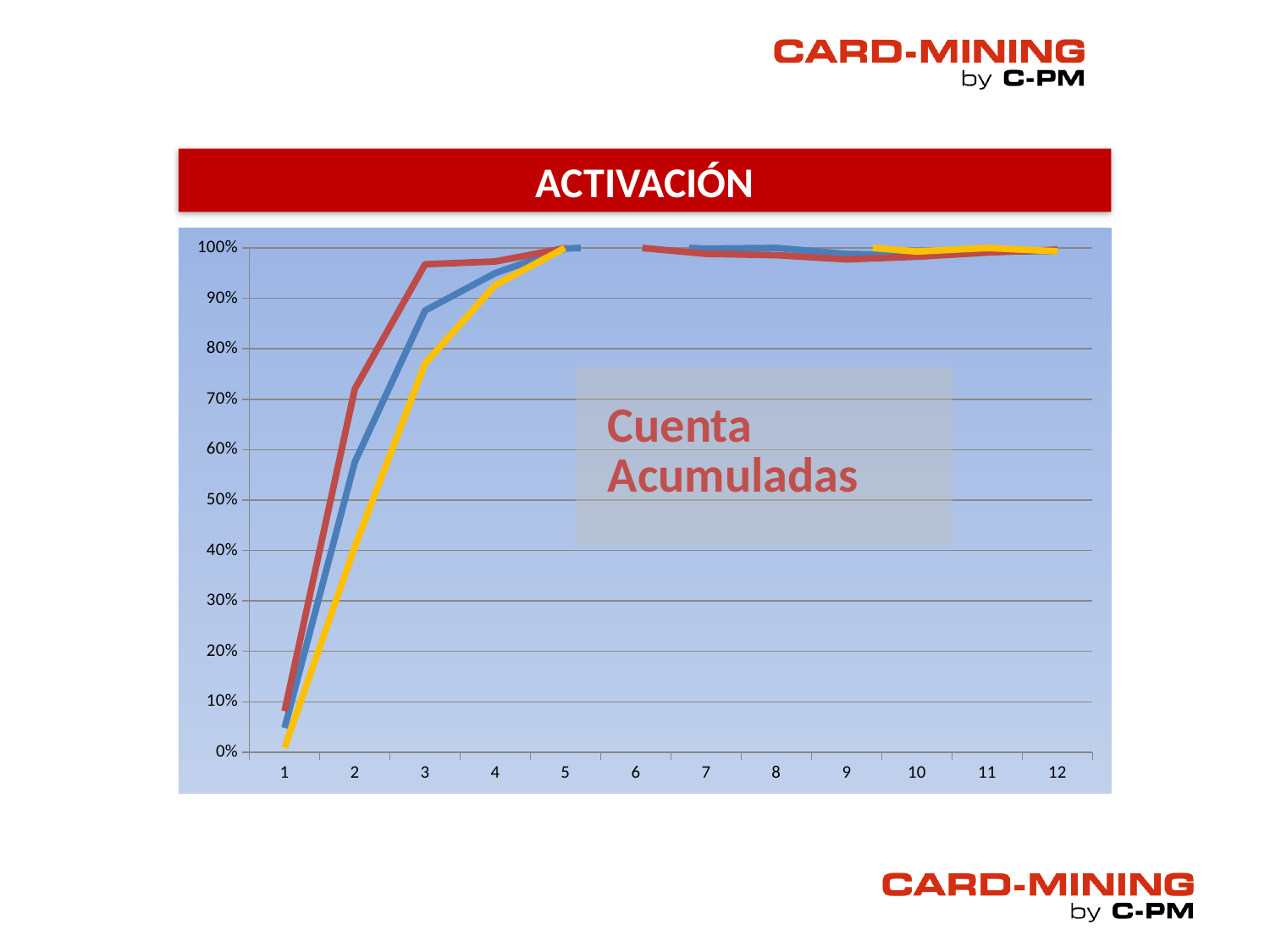
What kind of chart is shown on the slide? line chart What is the title shown above the chart? ACTIVACIÓN How many points are labelled on the x axis of the chart? 12 At x = 2, which line is higher, the red line or the yellow line? red line How many lines are plotted on the chart? 3 Is the value of the yellow line at x = 1 greater or less than 10%? less What text appears in the box overlaid on the chart? Cuenta Acumuladas Is the value of the red line at x = 3 greater or less than 90%? greater Is the value of the red line at x = 2 greater or less than 60%? greater Do the lines rise or fall from x = 1 to x = 5? rise